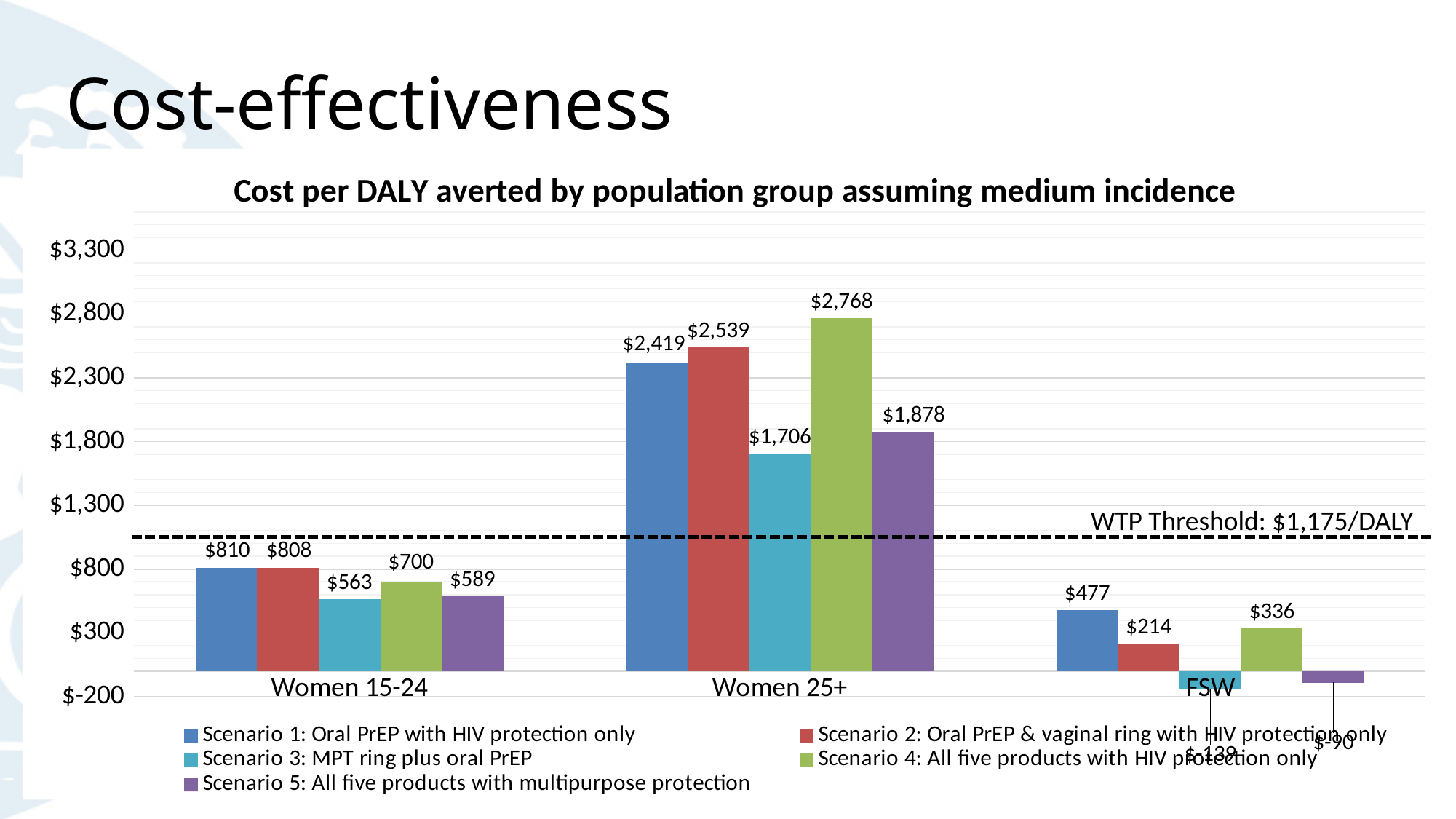
What is the cost per DALY averted for Scenario 1 in the Women 15-24 group? $810 What is the cost per DALY averted for Scenario 4 in the Women 25+ group? $2,768 How many population groups are shown on the x axis? 3 Which scenario has the lowest cost per DALY averted in the Women 15-24 group? Scenario 3: MPT ring plus oral PrEP Which scenario has the highest cost per DALY averted in the Women 25+ group? Scenario 4: All five products with HIV protection only Is the Scenario 2 value for Women 25+ greater or less than $2,300? greater Which is larger in the FSW group: the Scenario 1 value or the Scenario 4 value? Scenario 1 ($477) What WTP threshold is marked by the dashed line on the chart? $1,175/DALY What is the difference between the Scenario 4 and Scenario 5 values in the Women 25+ group? $890 What is the cost per DALY averted for Scenario 2 in the FSW group? $214 What is the cost per DALY averted for Scenario 3 in the Women 25+ group? $1,706 How many scenarios does the legend list? 5